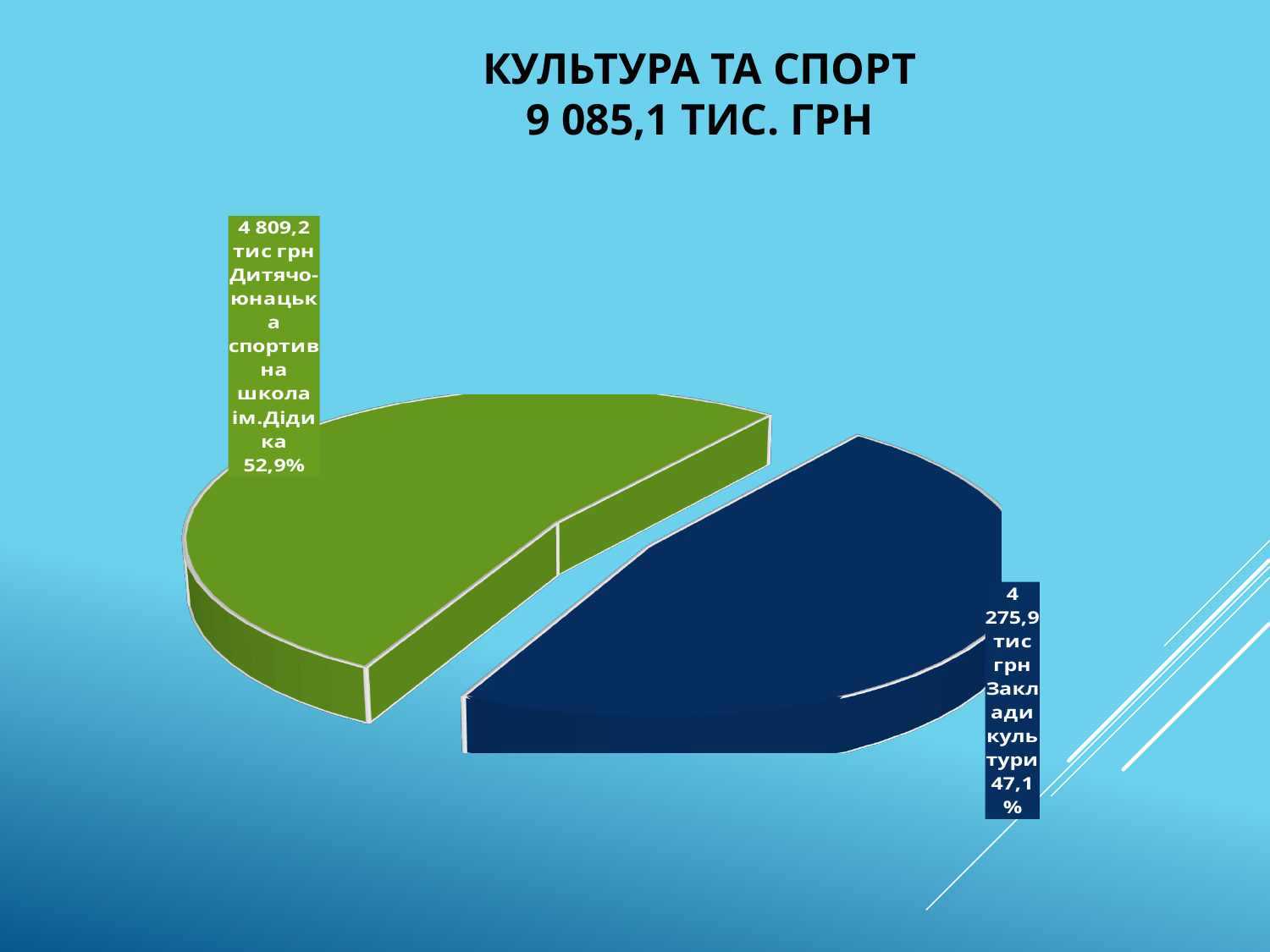
What is the total amount shown in the chart title? 9 085,1 тис. грн What is the value for Дитячо-юнацька спортивна школа ім.Дідика? 4 809,2 тис грн What colour is the slice for Заклади культури? Dark blue What is the difference in тис грн between Дитячо-юнацька спортивна школа ім.Дідика and Заклади культури? 533,3 тис грн Which slice is the smallest? Заклади культури How many slices does the pie chart have? 2 Which is larger: Дитячо-юнацька спортивна школа ім.Дідика or Заклади культури? Дитячо-юнацька спортивна школа ім.Дідика Which slice is the largest? Дитячо-юнацька спортивна школа ім.Дідика What share of the pie does Заклади культури represent? 47,1% What share of the pie does Дитячо-юнацька спортивна школа ім.Дідика represent? 52,9% What is the value for Заклади культури? 4 275,9 тис грн What kind of chart is shown on the slide? Pie chart